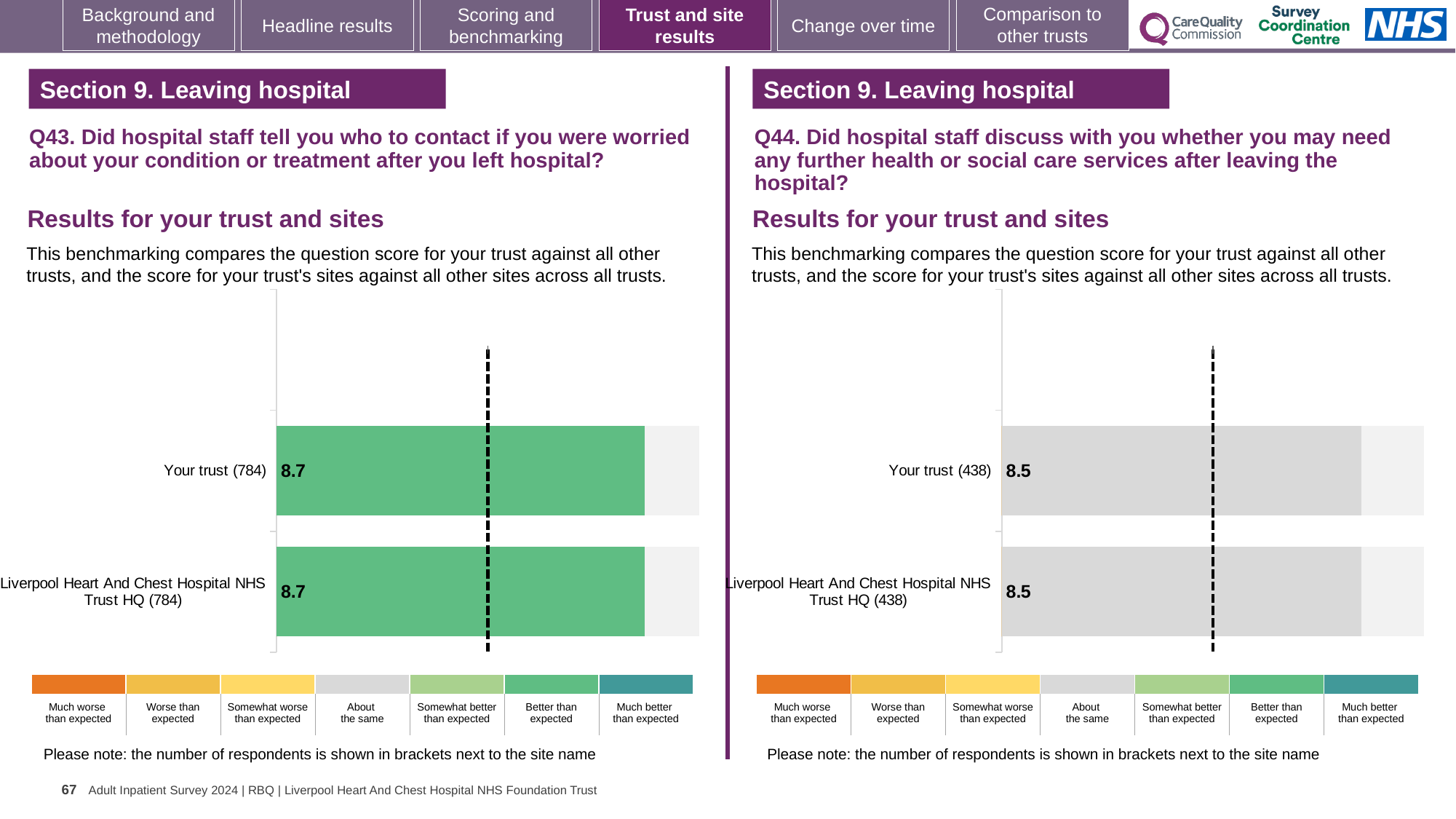
According to the colour key, which benchmark category do the bars on the Q43 chart (left) fall into? Better than expected On the Q44 chart (right), what is the score for Your trust (438)? 8.5 On the Q43 chart (left), what is the difference between the score for Your trust and the score for Liverpool Heart And Chest Hospital NHS Trust HQ? 0 On the Q44 chart (right), what is the difference between the score for Your trust and the score for Liverpool Heart And Chest Hospital NHS Trust HQ? 0 According to the colour key, which benchmark category do the bars on the Q44 chart (right) fall into? About the same On the Q43 chart (left), what is the score for Liverpool Heart And Chest Hospital NHS Trust HQ (784)? 8.7 How many bars are plotted on the Q44 chart (right)? 2 On the Q44 chart (right), what is the score for Liverpool Heart And Chest Hospital NHS Trust HQ (438)? 8.5 Is the Your trust score on the Q43 chart (left) larger than the Your trust score on the Q44 chart (right)? Yes What type of chart is used for the Q43 results on the left? Bar chart How many bars are plotted on the Q43 chart (left)? 2 On the Q43 chart (left), what is the score for Your trust (784)? 8.7